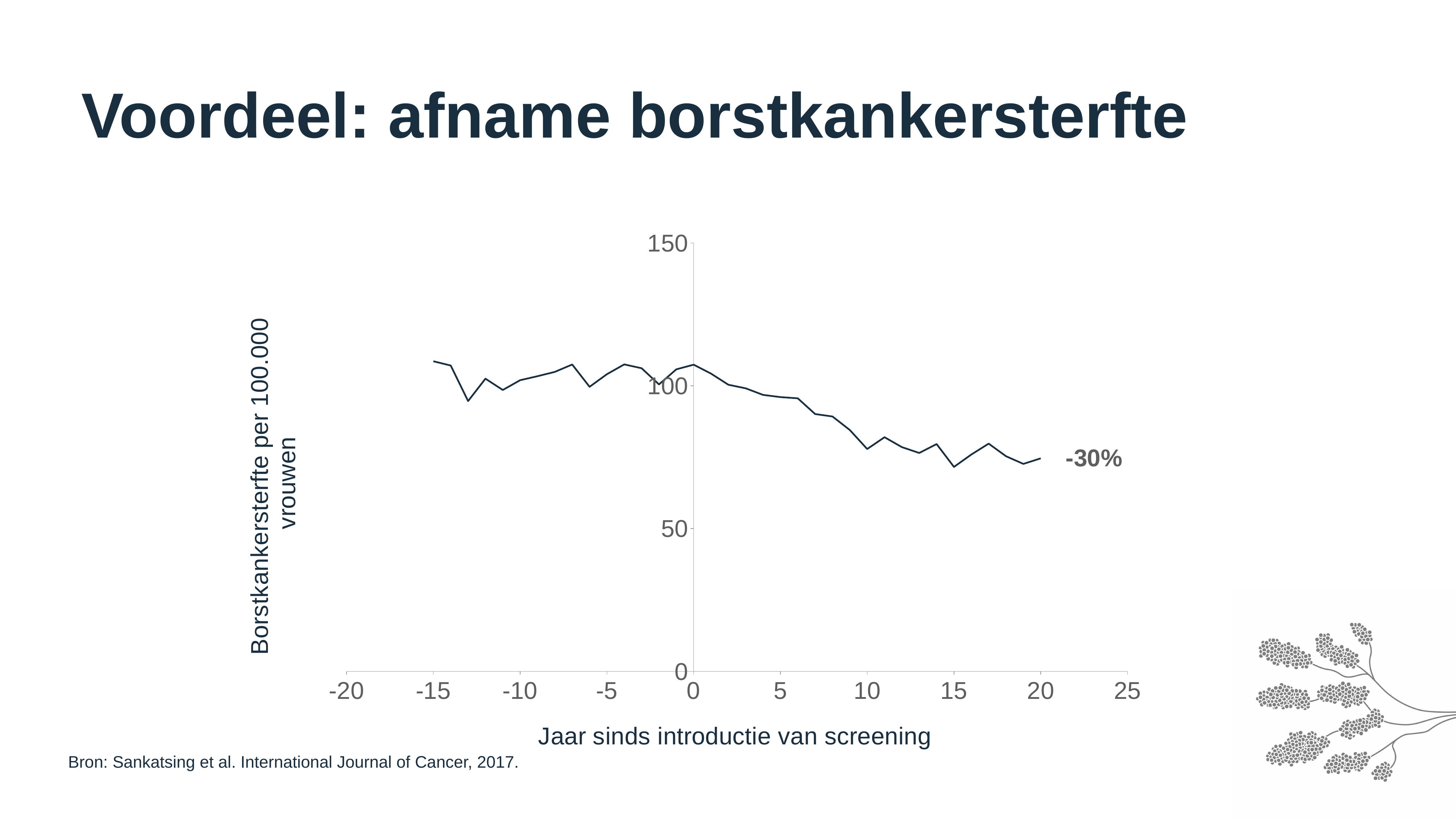
Does the line generally rise or fall as the years since introduction of screening increase? fall Is the value at year 10 greater or less than 50? greater What is the title of the slide containing the chart? Voordeel: afname borstkankersterfte Is the value at year 15 greater or less than 100? less Which is larger: the value at year 0 or the value at year 15? year 0 How many lines are plotted on the chart? 1 What percentage change is annotated at the right end of the line? -30% Is the value at year 20 greater or less than 100? less Which is larger: the value at year -15 or the value at year 20? year -15 What kind of chart is shown on the slide? line chart What is the label of the x axis? Jaar sinds introductie van screening